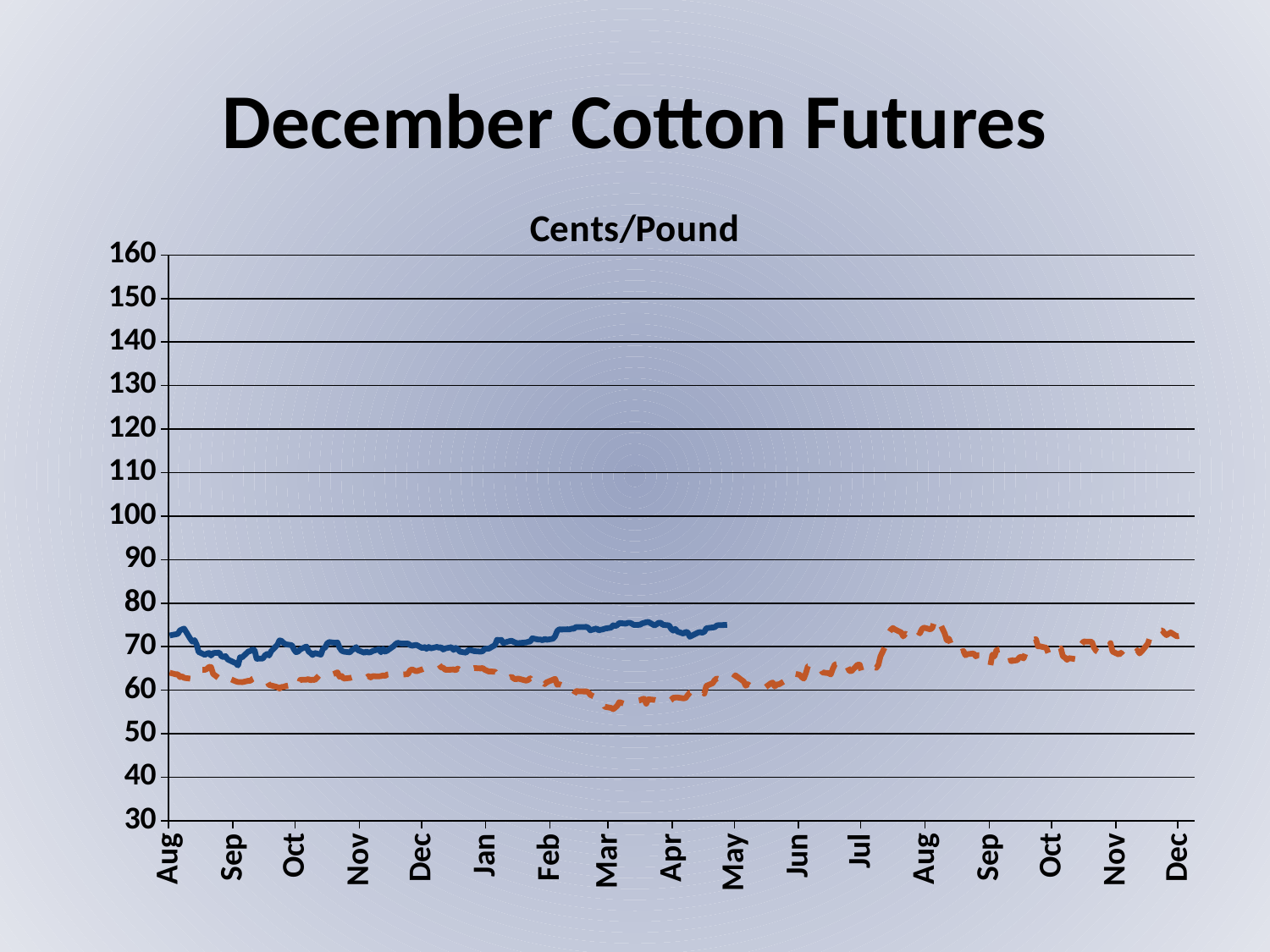
Is the value of the solid blue line at Sep greater or less than 70? less How many month labels are shown along the x axis? 17 Does the dashed orange line rise or fall between Mar and the second Aug label? rise What is the title shown above the chart's plot area? Cents/Pound How many lines are plotted on the chart? 2 What is the highest value shown on the y axis? 160 At Mar, which line has the higher value, the solid blue line or the dashed orange line? solid blue line Is the value of the solid blue line at the first Aug label greater or less than 70? greater Is the value of the dashed orange line at the second Aug label greater or less than 70? greater What kind of chart is shown on the slide? line chart